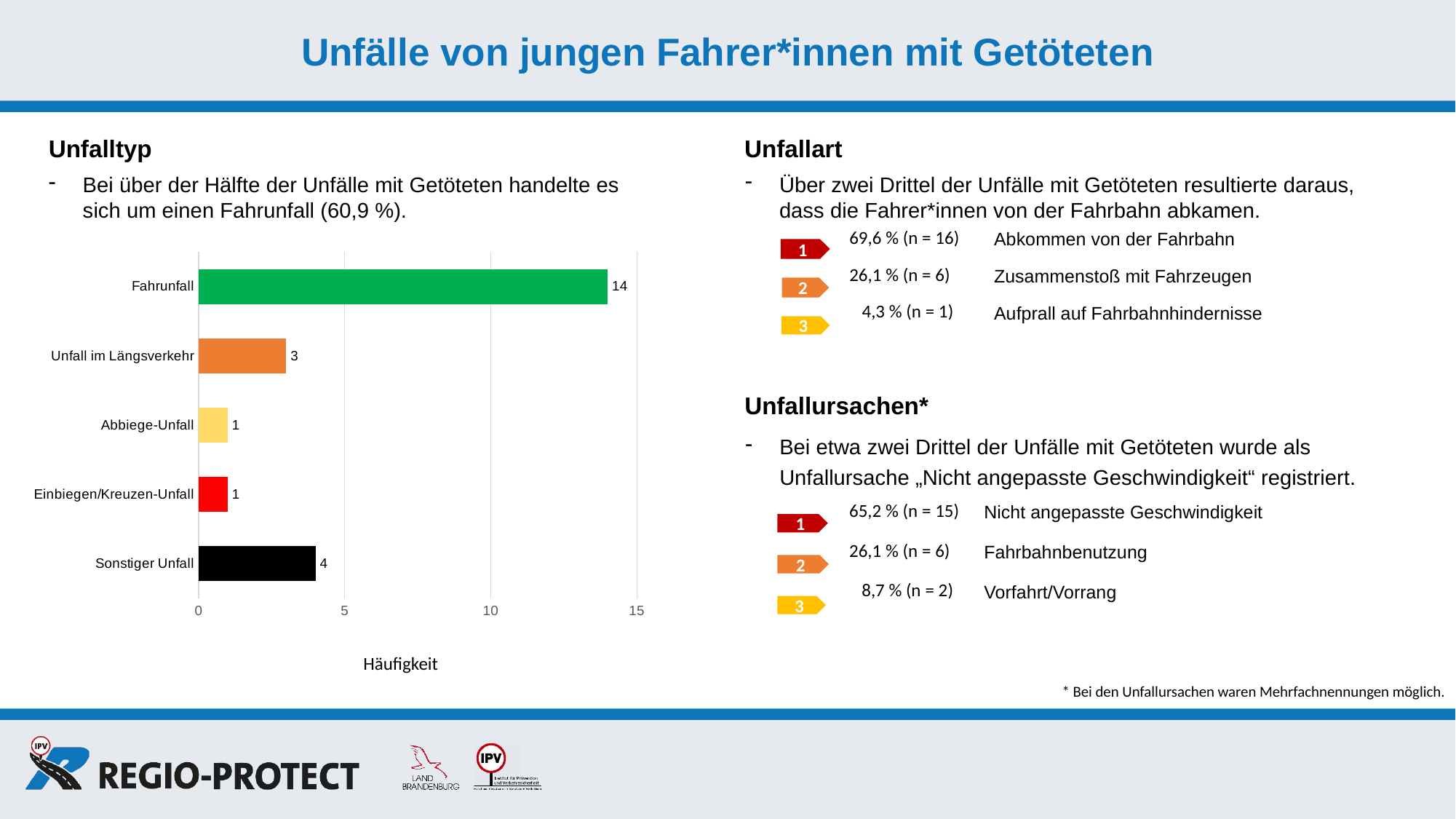
What is the difference between the values for Sonstiger Unfall and Unfall im Längsverkehr? 1 What is the value for Abbiege-Unfall? 1 How many categories are shown in the bar chart? 5 What is the value for Unfall im Längsverkehr? 3 Which is larger, the value for Unfall im Längsverkehr or the value for Sonstiger Unfall? Sonstiger Unfall What type of chart is shown on the slide? bar chart What is the value for Sonstiger Unfall? 4 What is the difference between the values for Fahrunfall and Sonstiger Unfall? 10 What is the label of the horizontal axis of the bar chart? Häufigkeit Is the value for Fahrunfall greater or less than 10? greater What is the value for Fahrunfall? 14 Which category has the highest value? Fahrunfall